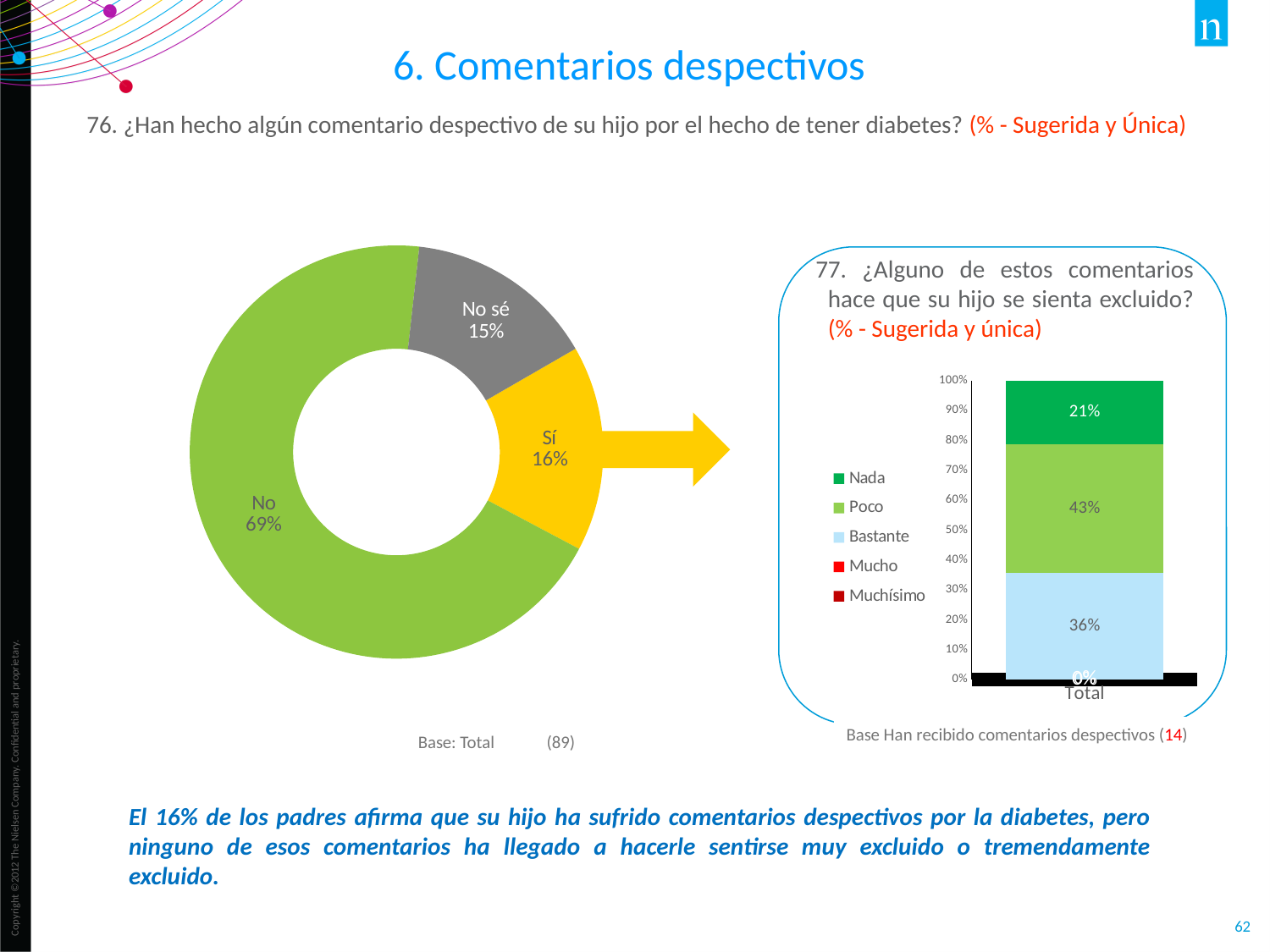
In the stacked bar chart on the right, which is larger, "Poco" or "Bastante"? Poco In the stacked bar chart on the right, what percentage corresponds to "Bastante"? 36% In the stacked bar chart on the right, how many series does the legend list? 5 In the donut chart on the left, which category has the smallest share? No sé In the stacked bar chart on the right, what percentage corresponds to "Nada"? 21% In the donut chart on the left, what is the difference in percentage points between "No" and "Sí"? 53 In the stacked bar chart on the right, what percentage corresponds to "Poco"? 43% In the donut chart on the left, which category has the largest share? No In the donut chart on the left, what percentage of respondents answered "No sé"? 15% In the donut chart on the left, what percentage of respondents answered "Sí"? 16% In the donut chart on the left, how many categories are shown? 3 In the donut chart on the left, what percentage of respondents answered "No"? 69%